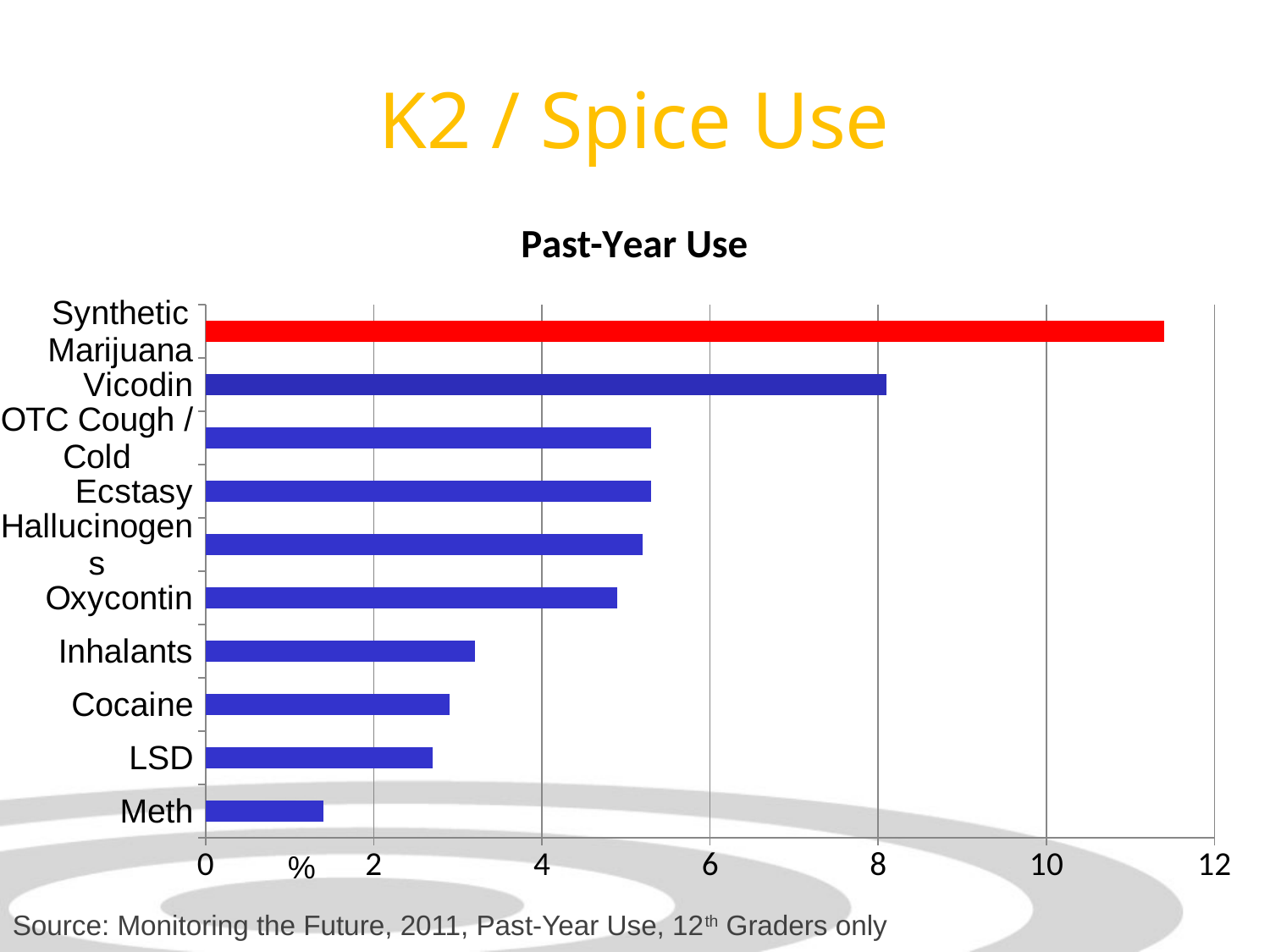
Is the value for Vicodin greater or less than 6? greater What colour is the bar for Synthetic Marijuana? red Which category has the highest past-year use? Synthetic Marijuana Is the value for Inhalants greater or less than 4? less Which is larger, the value for Synthetic Marijuana or the value for Vicodin? Synthetic Marijuana Which is larger, the value for Cocaine or the value for Meth? Cocaine Is the value for Oxycontin greater or less than 6? less What kind of chart is shown on the slide? bar chart Which category has the lowest past-year use? Meth How many categories are plotted in the chart? 10